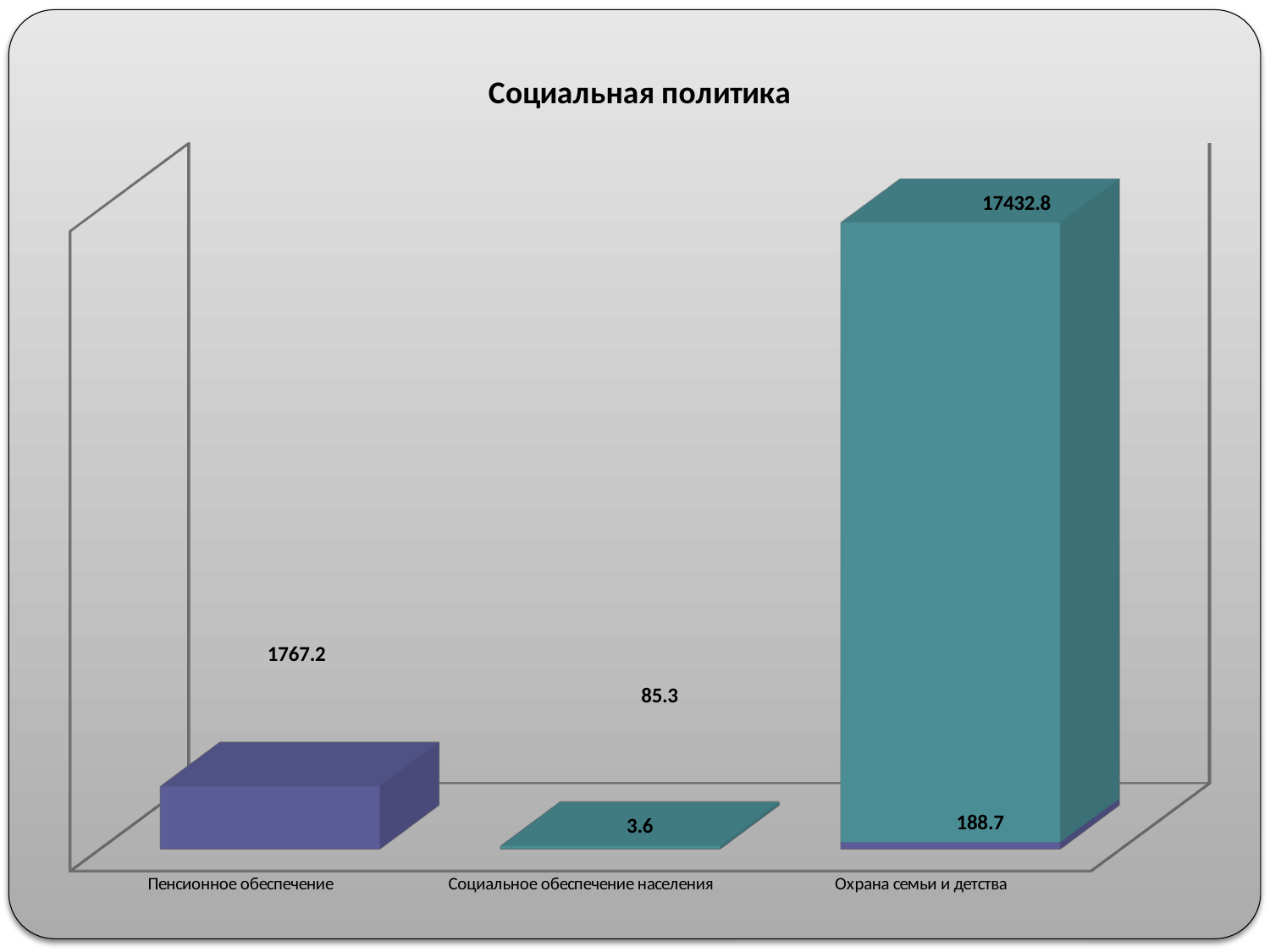
How many categories are shown on the x axis of the chart? 3 What is the title of the chart? Социальная политика What is the difference between the purple bar value for Пенсионное обеспечение (1767.2) and the purple segment value for Охрана семьи и детства (188.7)? 1578.5 What value is labelled on the teal bar for Социальное обеспечение населения? 3.6 What value is labelled on the purple segment at the bottom of the Охрана семьи и детства bar? 188.7 What is the upper value labelled above the Социальное обеспечение населения bar? 85.3 Which category has the tallest bar? Охрана семьи и детства What is the difference between the two values labelled for Охрана семьи и детства, 17432.8 and 188.7? 17244.1 What kind of chart is shown on the slide? bar chart What is the largest value labelled for Охрана семьи и детства? 17432.8 Which is larger: the purple bar for Пенсионное обеспечение (1767.2) or the teal bar for Охрана семьи и детства (17432.8)? Охрана семьи и детства What value is labelled on the purple bar for Пенсионное обеспечение? 1767.2